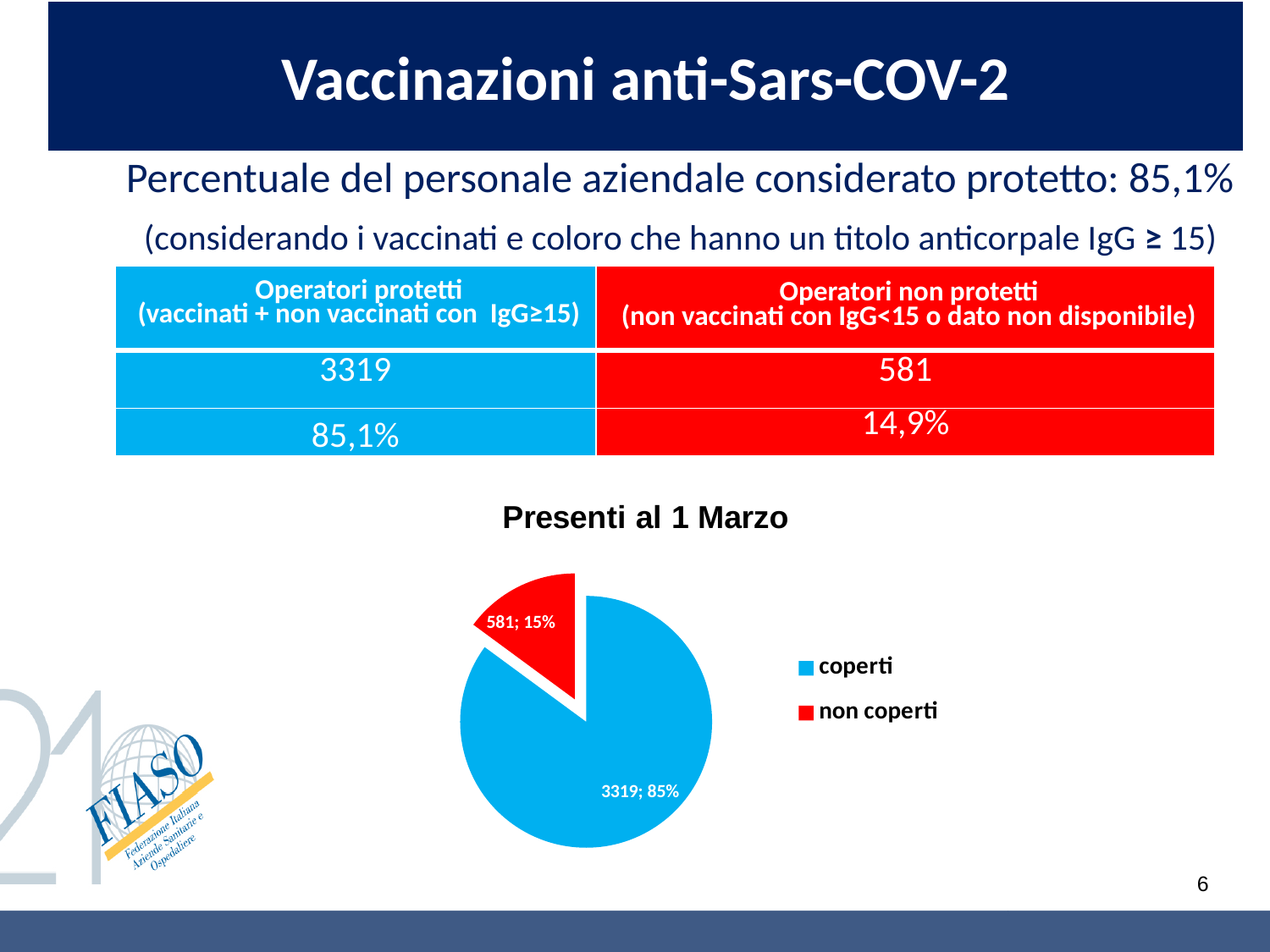
How many slices does the pie chart have? 2 What is the difference between the 'coperti' and 'non coperti' values? 2738 What is the value for the 'non coperti' slice? 581 What is the value for the 'coperti' slice? 3319 What share of the pie does the 'non coperti' slice represent? 15% What type of chart is shown on the slide? pie chart Which colour represents 'non coperti' in the chart? red Which slice is the largest? coperti What share of the pie does the 'coperti' slice represent? 85% How many entries does the chart legend list? 2 What is the title of the chart? Presenti al 1 Marzo Which slice is the smallest? non coperti